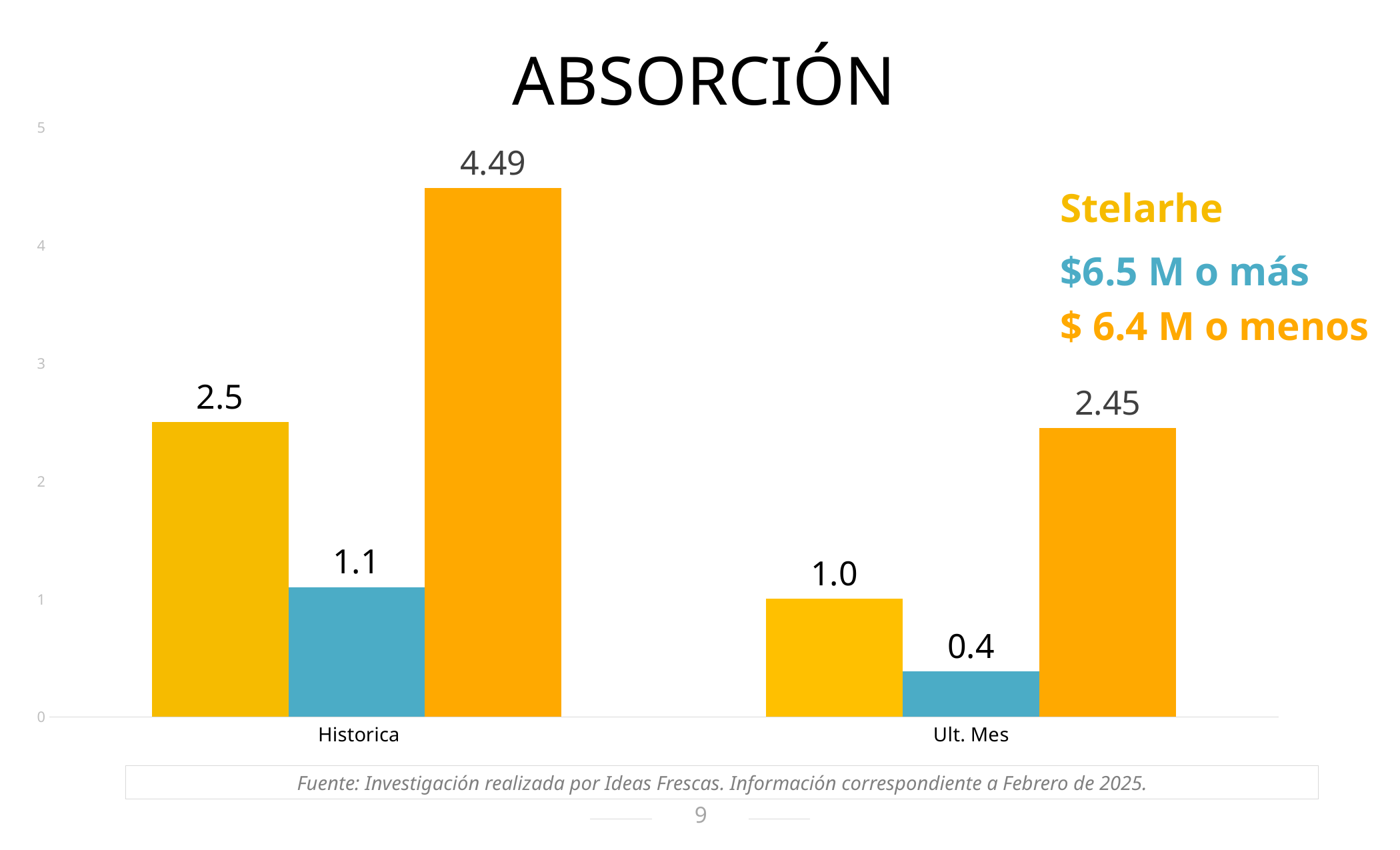
Which is larger: the Stelarhe value for Historica or the $ 6.4 M o menos value for Ult. Mes? Stelarhe value for Historica What is the value for Stelarhe in the Historica category? 2.5 What is the title of the chart? ABSORCIÓN What is the value for $ 6.4 M o menos in the Historica category? 4.49 What is the difference between the $ 6.4 M o menos values for Historica and Ult. Mes? 2.04 Which series has the lowest value in the Ult. Mes category? $6.5 M o más How many categories are shown on the x axis? 2 What is the value for Stelarhe in the Ult. Mes category? 1.0 What kind of chart is shown on the slide? Bar chart What is the value for $6.5 M o más in the Ult. Mes category? 0.4 Which series has the highest value in the Historica category? $ 6.4 M o menos How many series does the legend list? 3